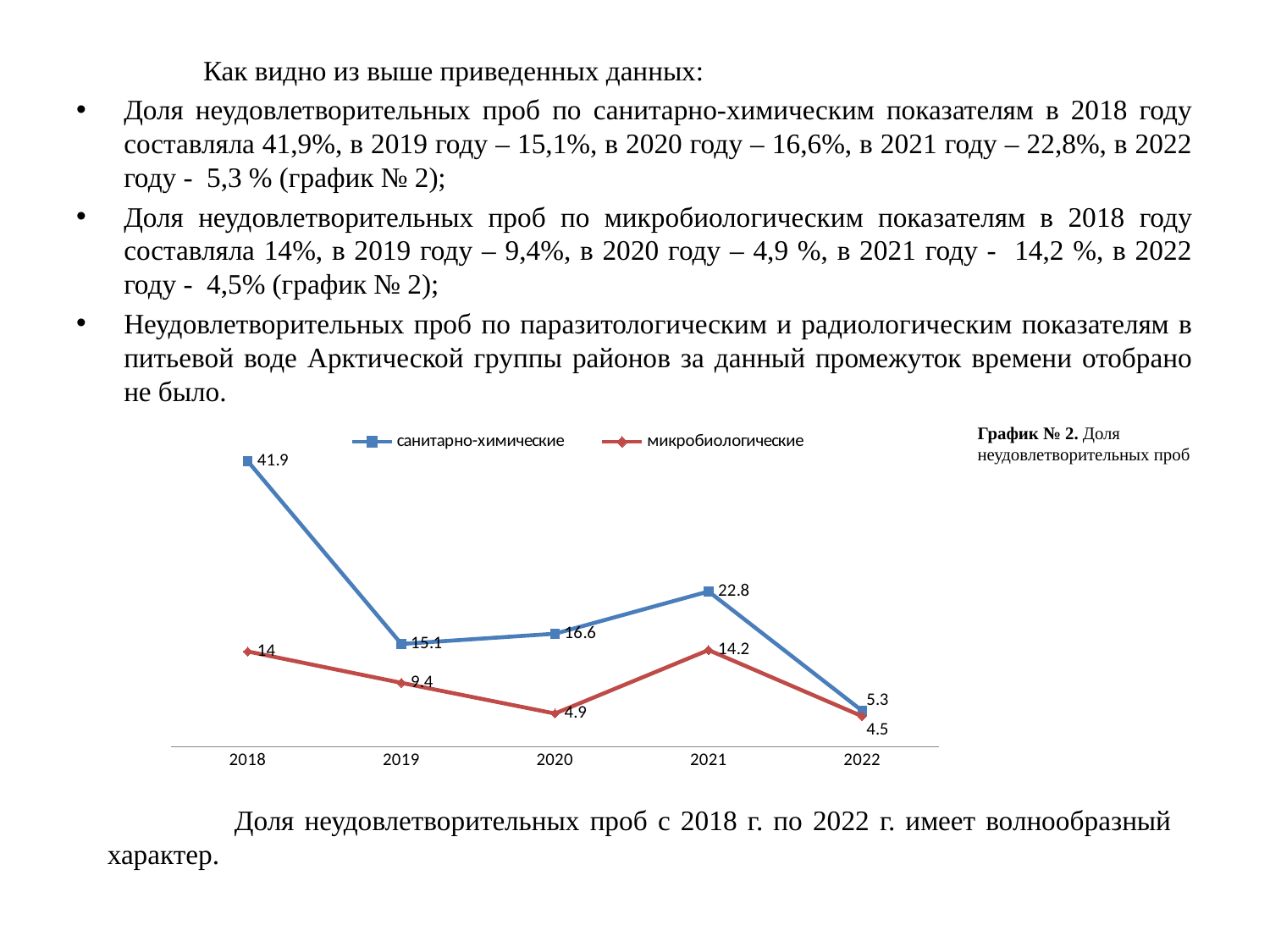
How many series does the legend list? 2 How many years are shown on the x axis? 5 What is the value for микробиологические in 2022? 4.5 In which year is the value for санитарно-химические highest? 2018 What is the value for санитарно-химические in 2018? 41.9 What is the difference between the санитарно-химические and микробиологические values in 2019? 5.7 Does the value for санитарно-химические rise or fall from 2018 to 2019? fall What is the value for санитарно-химические in 2021? 22.8 What type of chart is shown on the slide? line chart Which series has the larger value in 2021, санитарно-химические or микробиологические? санитарно-химические What is the value for микробиологические in 2020? 4.9 In which year is the value for микробиологические lowest? 2022